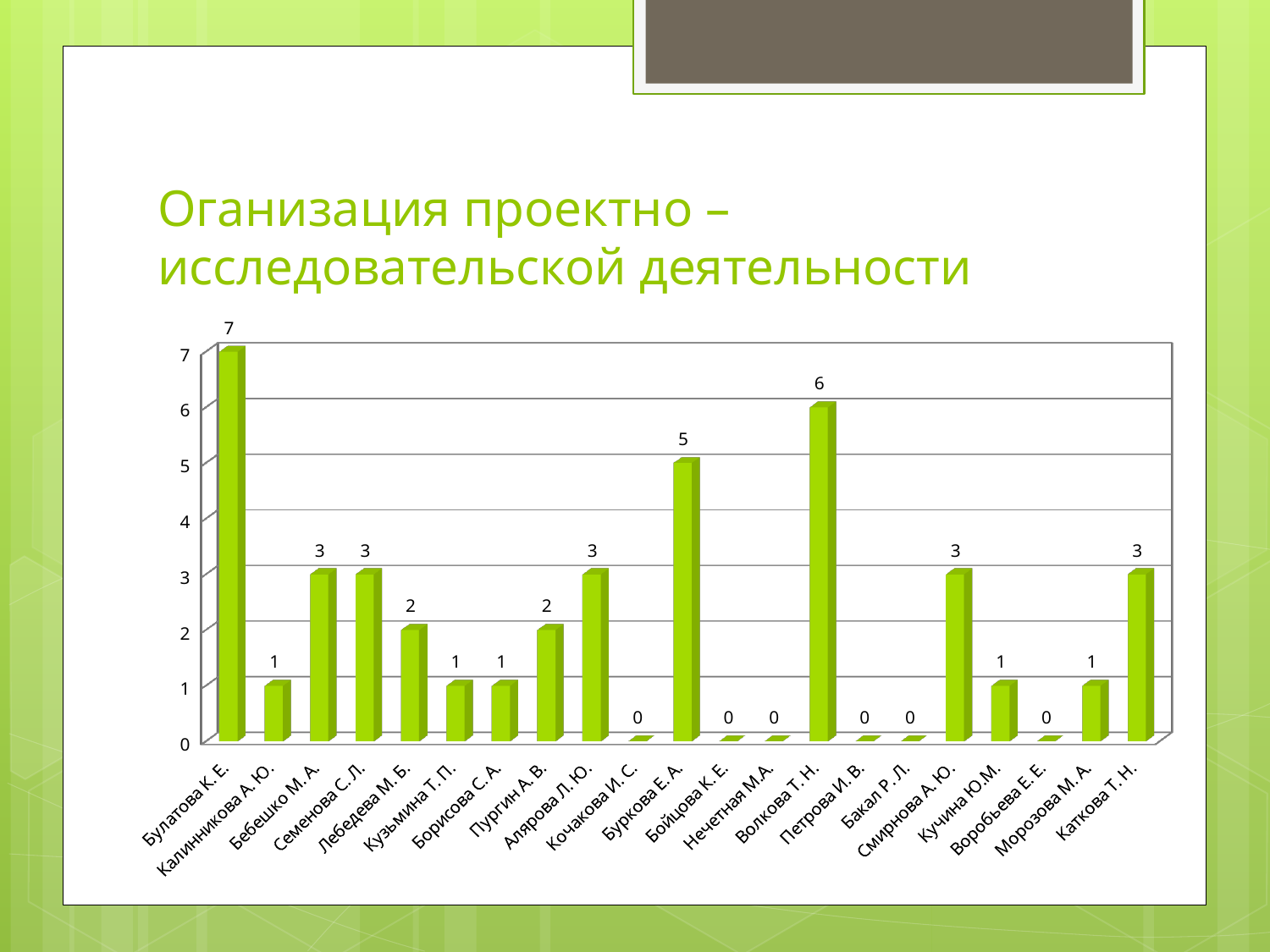
What value is shown for Волкова Т. Н.? 6 What value is shown for Булатова К. Е.? 7 What kind of chart is shown on the slide? Bar chart Which is larger, the value for Пургин А. В. or the value for Алярова Л. Ю.? Алярова Л. Ю. What value is shown for Лебедева М. Б.? 2 How many categories have a value of 0? 6 What is the difference between the values for Буркова Е. А. and Смирнова А. Ю.? 2 Which category has the highest value? Булатова К. Е. Which is larger, the value for Волкова Т. Н. or the value for Буркова Е. А.? Волкова Т. Н. What value is shown for Буркова Е. А.? 5 How many categories are shown on the x axis? 21 What is the difference between the values for Булатова К. Е. and Волкова Т. Н.? 1